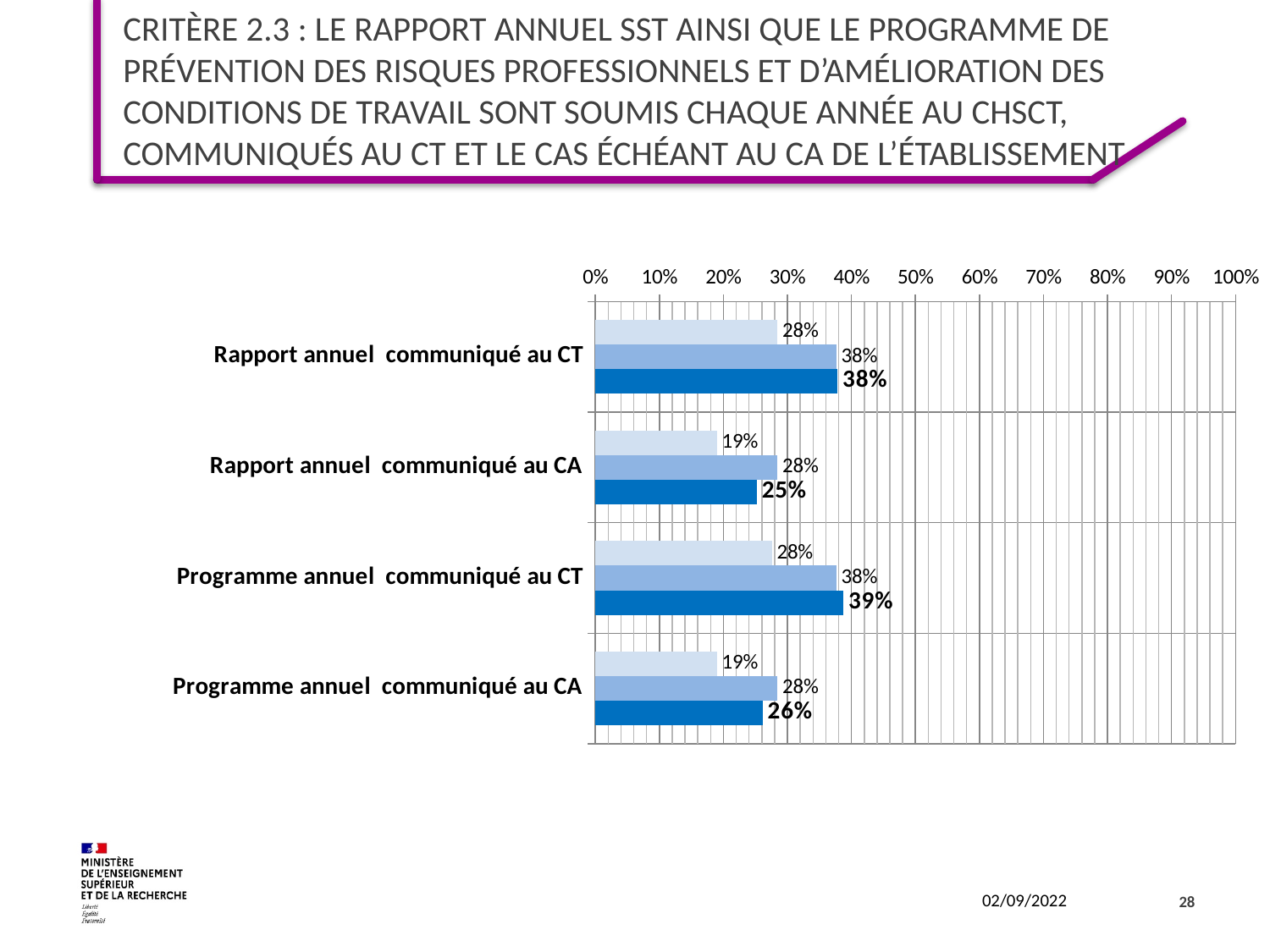
What is the value of the dark blue (bottom) bar for 'Programme annuel communiqué au CA'? 26% What is the value of the dark blue (bottom) bar for 'Rapport annuel communiqué au CT'? 38% What is the difference between the medium blue bar and the light blue bar for 'Rapport annuel communiqué au CT'? 10% What is the value of the dark blue (bottom) bar for 'Programme annuel communiqué au CT'? 39% Which category has the lowest dark blue (bottom) bar value? Rapport annuel communiqué au CA What is the value of the light blue (top) bar for 'Rapport annuel communiqué au CA'? 19% What kind of chart is shown on the slide? bar chart What is the value of the medium blue (middle) bar for 'Programme annuel communiqué au CA'? 28% Is the dark blue bar value for 'Programme annuel communiqué au CT' greater or less than 50%? less How many categories are shown on the chart? 4 Is the dark blue bar for 'Rapport annuel communiqué au CA' larger or smaller than the dark blue bar for 'Programme annuel communiqué au CA'? smaller Which category has the highest dark blue (bottom) bar value? Programme annuel communiqué au CT